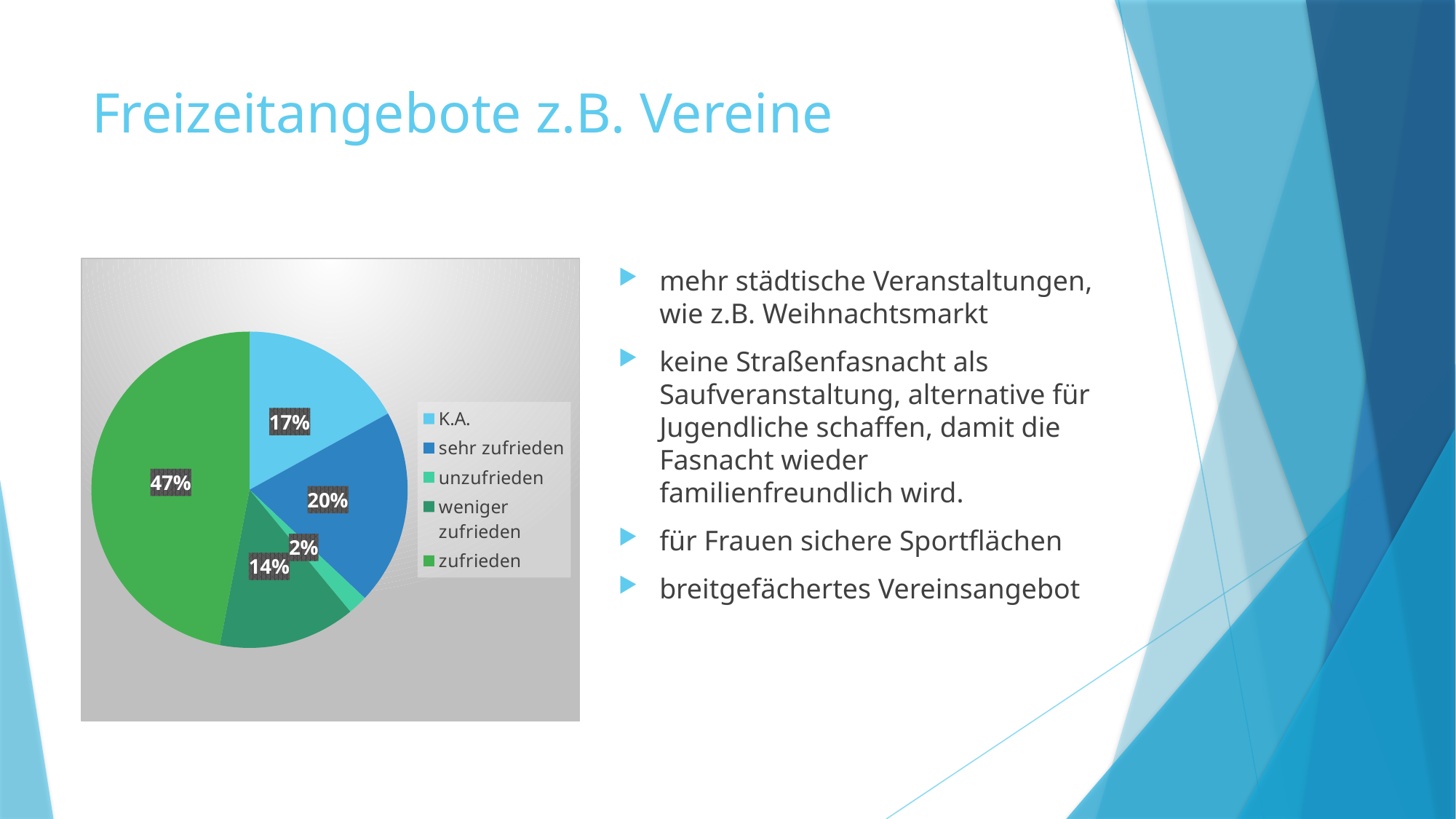
What share of the pie does "sehr zufrieden" have? 20% What share of the pie does "zufrieden" have? 47% Which category has the largest slice of the pie? zufrieden What share of the pie does "weniger zufrieden" have? 14% Which category has the smallest slice of the pie? unzufrieden What colour is the slice for "K.A." in the pie chart? light blue What kind of chart is shown on the slide? pie chart Which is larger, the slice for "sehr zufrieden" or the slice for "K.A."? sehr zufrieden What is the difference in percentage points between "zufrieden" and "sehr zufrieden"? 27 What share of the pie does "K.A." have? 17% How many categories does the pie chart show? 5 What share of the pie does "unzufrieden" have? 2%